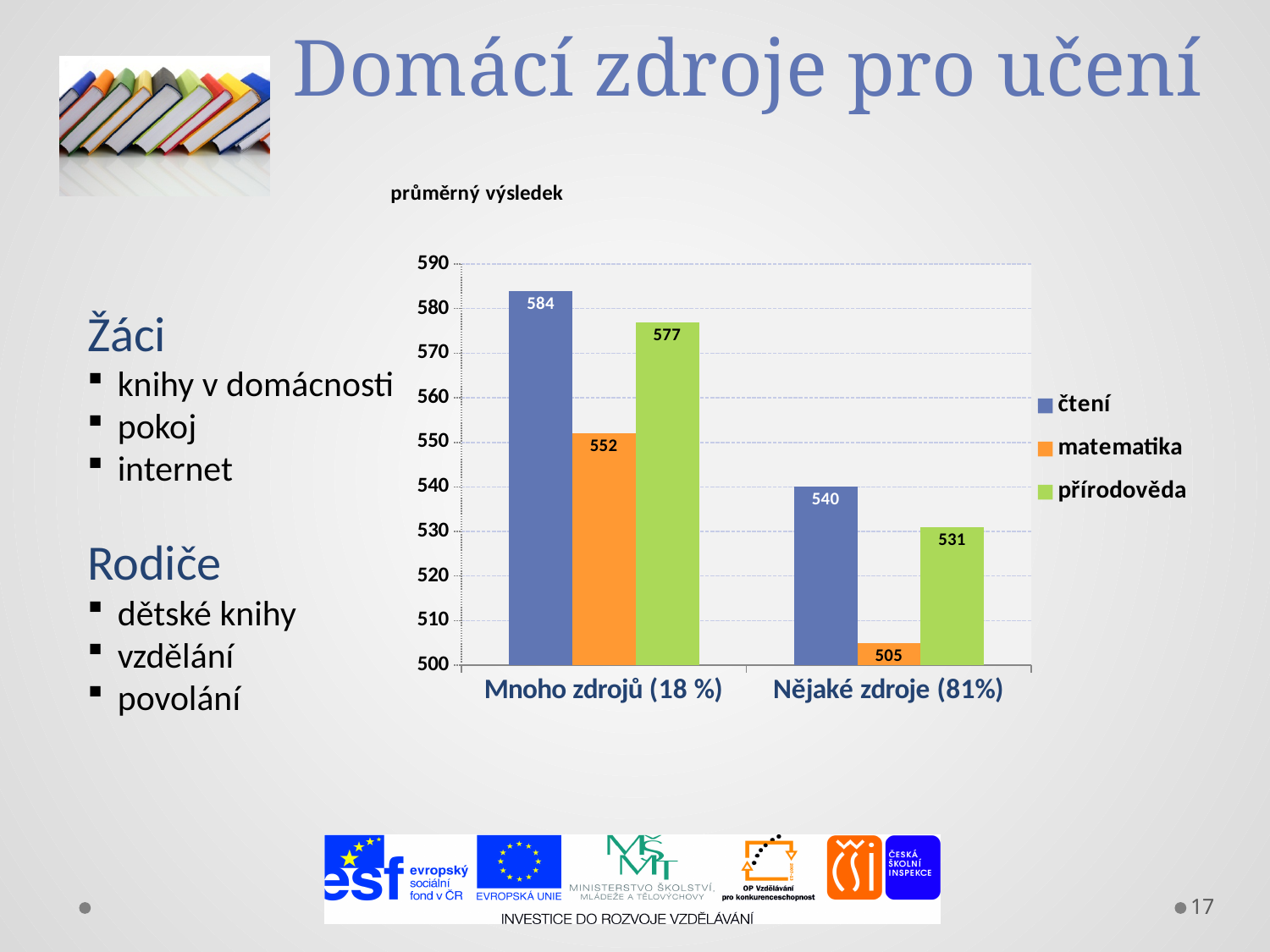
What is the title of the chart? průměrný výsledek What kind of chart is shown on the slide? bar chart Which series has the highest value in the Nějaké zdroje (81%) category? čtení What is the value for přírodověda in the Mnoho zdrojů (18 %) category? 577 Which is larger: the matematika value for Mnoho zdrojů (18 %) or the přírodověda value for Nějaké zdroje (81%)? matematika for Mnoho zdrojů (18 %) What is the value for matematika in the Nějaké zdroje (81%) category? 505 Which series has the lowest value in the Mnoho zdrojů (18 %) category? matematika How many series does the legend list? 3 What is the value for čtení in the Mnoho zdrojů (18 %) category? 584 What is the difference between the čtení values for Mnoho zdrojů (18 %) and Nějaké zdroje (81%)? 44 How many categories are shown on the x axis? 2 Do the čtení values rise or fall from Mnoho zdrojů (18 %) to Nějaké zdroje (81%)? fall